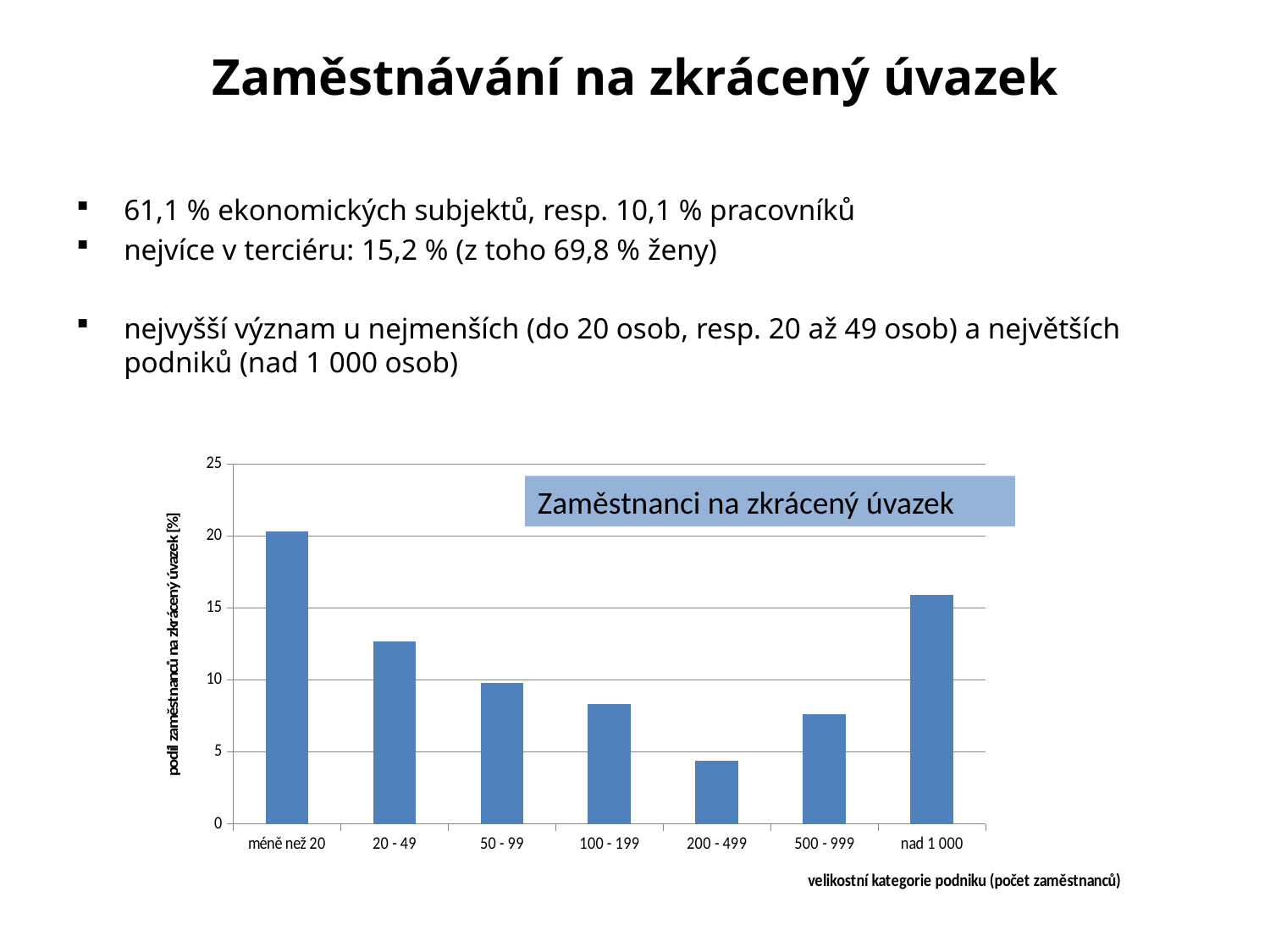
What is the title of the chart? Zaměstnanci na zkrácený úvazek What is the label of the x axis of the chart? velikostní kategorie podniku (počet zaměstnanců) How many company size categories are shown on the x axis of the chart? 7 Which company size category has the lowest share of part-time employees? 200 - 499 What kind of chart is shown on the slide? bar chart Is the value for '200 - 499' greater or less than 5? less Is the value for 'nad 1 000' greater or less than 15? greater Which has a larger value, '20 - 49' or 'nad 1 000'? nad 1 000 Which has a larger value, '100 - 199' or '500 - 999'? 100 - 199 Which company size category has the highest share of part-time employees? méně než 20